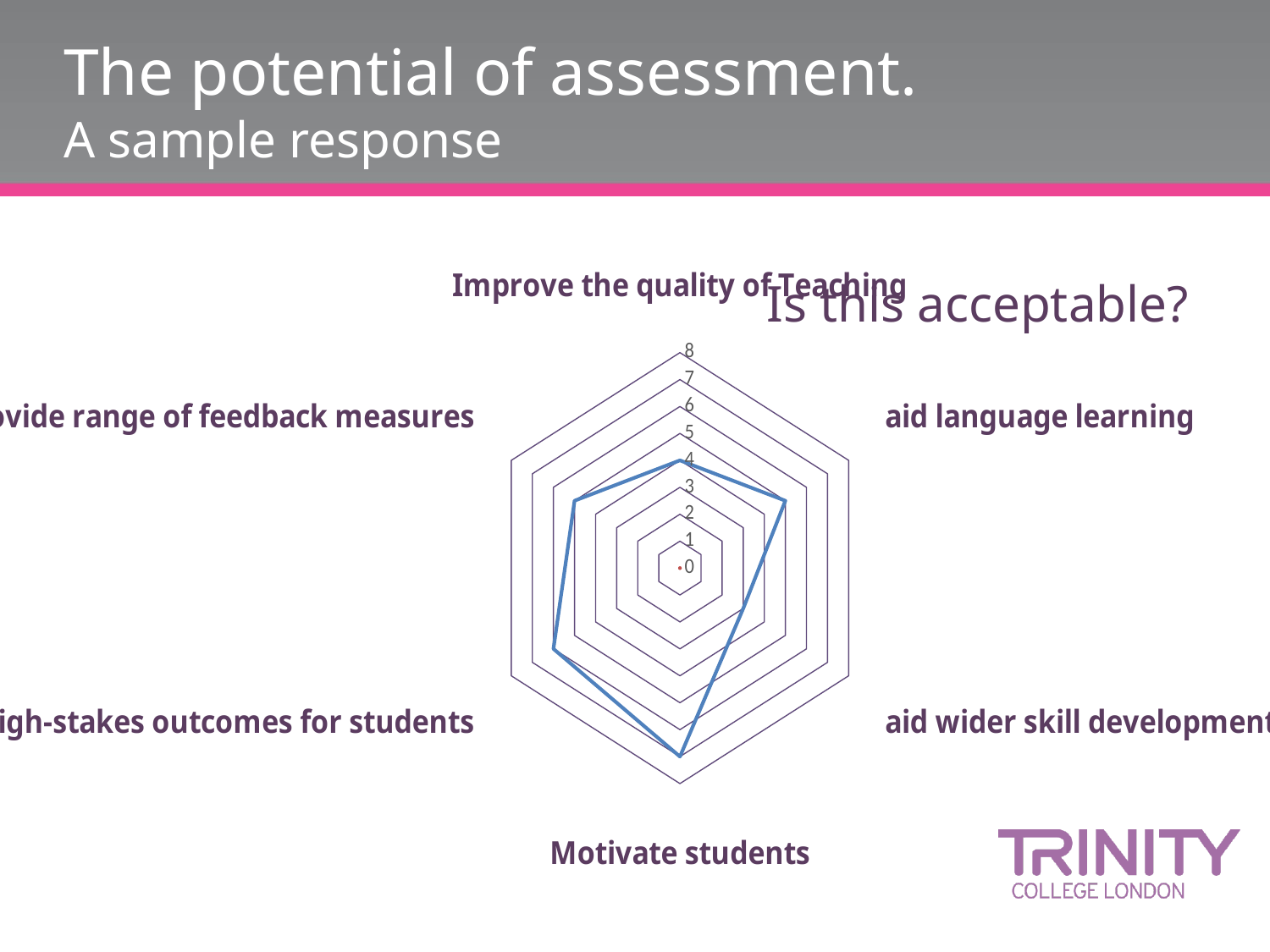
How many categories (axes) does the radar chart have? 6 What is the highest value shown on the radar chart's axis scale? 8 Which category has the highest value on the radar chart? Motivate students Which is larger on the radar chart: the value for High-stakes outcomes for students or the value for aid wider skill development? High-stakes outcomes for students Which category label appears at the bottom of the radar chart? Motivate students What kind of chart is shown on the slide? Radar chart What is the value for Improve the quality of Teaching on the radar chart? 4 Is the value for Motivate students greater or less than 6? greater Which is larger on the radar chart: the value for Motivate students or the value for Improve the quality of Teaching? Motivate students Is the value for aid wider skill development greater or less than 4? less Is the value for Improve the quality of Teaching greater or less than 6? less